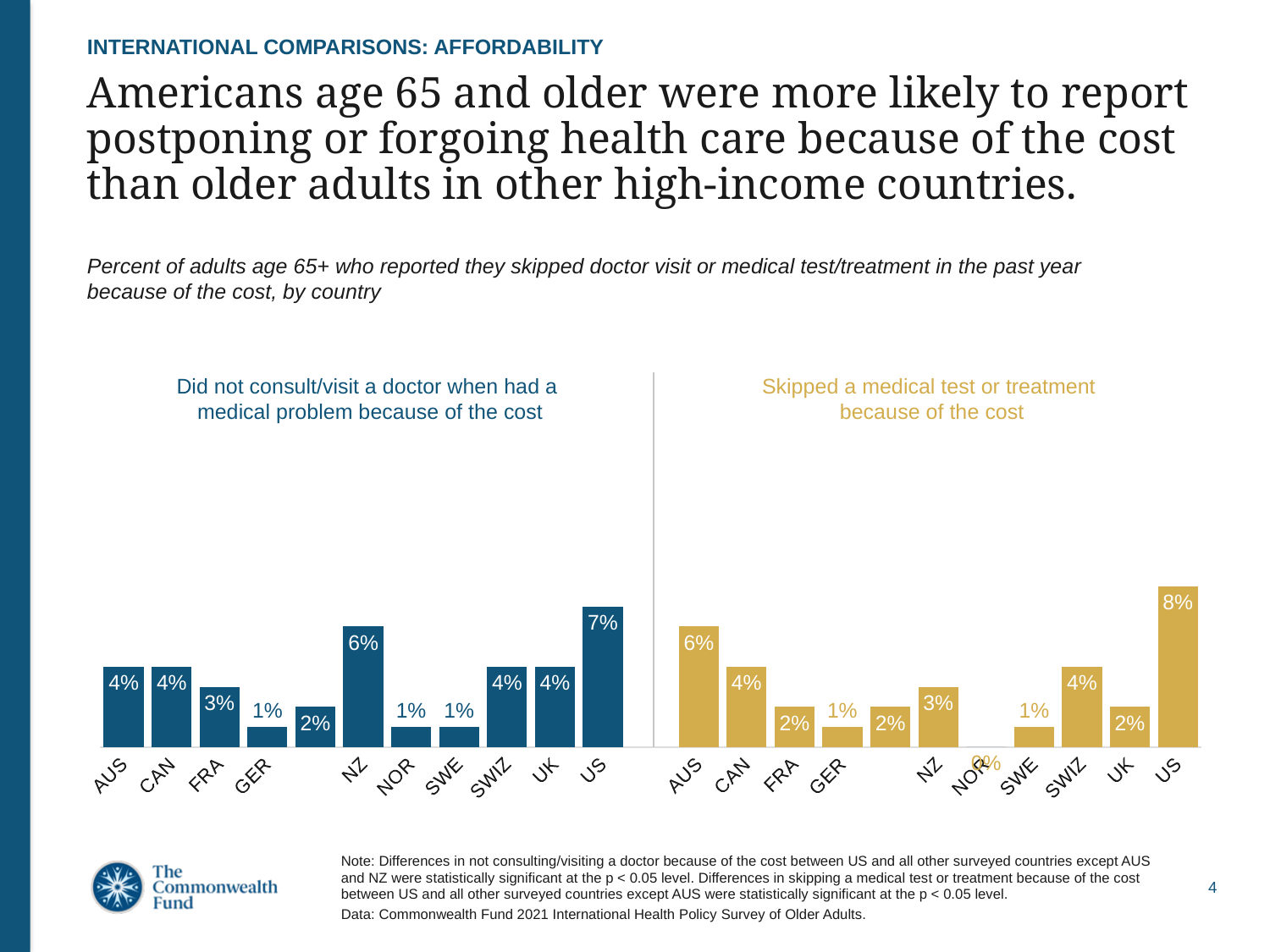
What type of chart is used on this slide? Bar chart In the chart 'Skipped a medical test or treatment because of the cost', what is the value for NOR? 0% In the chart 'Did not consult/visit a doctor when had a medical problem because of the cost', what is the value for NZ? 6% In the chart 'Skipped a medical test or treatment because of the cost', what is the value for AUS? 6% In the chart 'Skipped a medical test or treatment because of the cost', which country has the lowest value? NOR In the chart 'Did not consult/visit a doctor when had a medical problem because of the cost', which country has the highest value? US In the chart 'Skipped a medical test or treatment because of the cost', which is larger, the value for CAN or the value for UK? CAN In the chart 'Skipped a medical test or treatment because of the cost', what is the difference between the US value and the AUS value? 2% In the chart 'Did not consult/visit a doctor when had a medical problem because of the cost', what is the value for US? 7% How many bars are shown in the chart 'Did not consult/visit a doctor when had a medical problem because of the cost'? 11 In the chart 'Skipped a medical test or treatment because of the cost', which country has the highest value? US In the chart 'Did not consult/visit a doctor when had a medical problem because of the cost', what is the difference between the US value and the NZ value? 1%